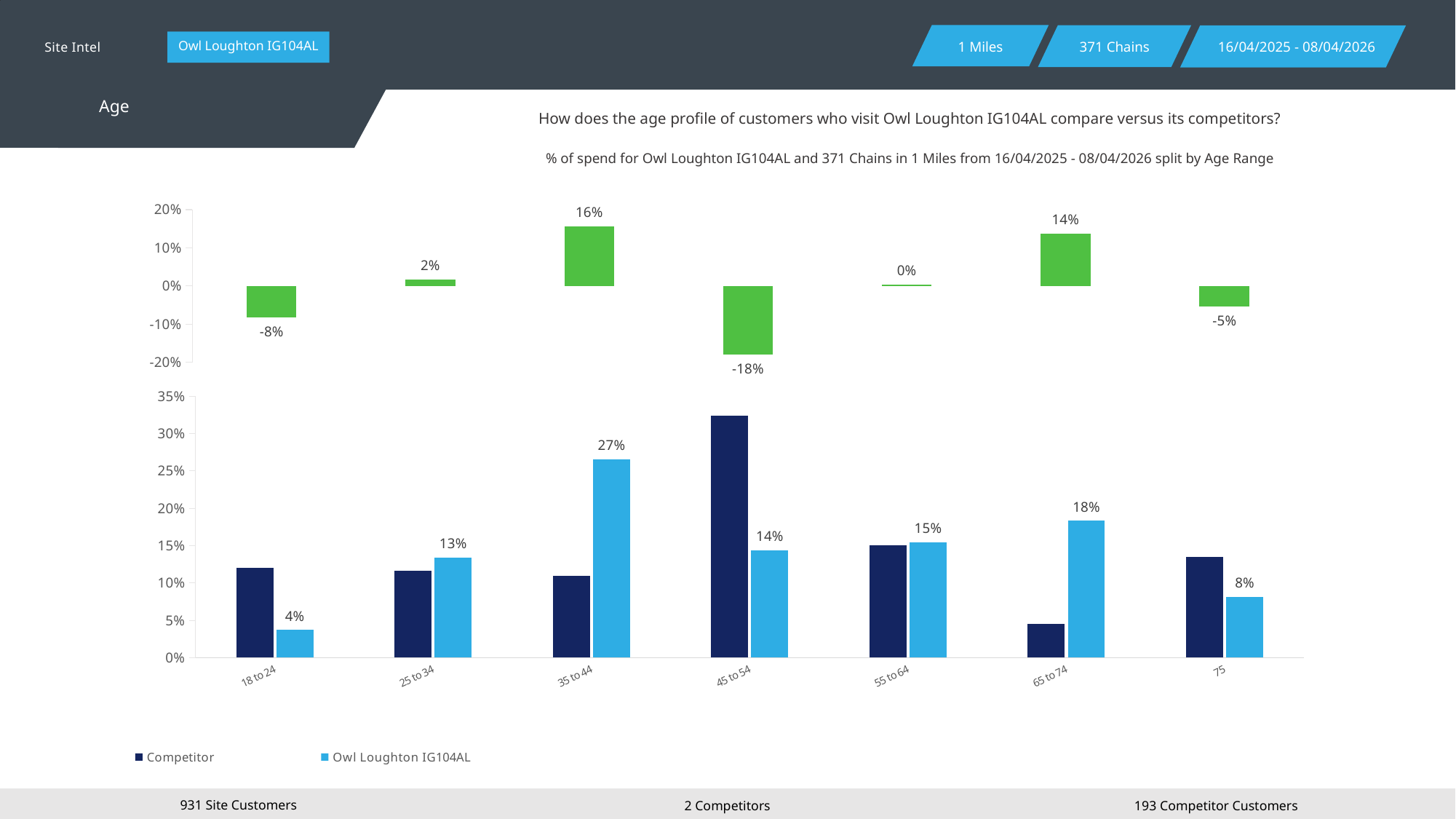
In the top chart, what is the value for the 18 to 24 age range? -8% In the bottom chart, what is the Owl Loughton IG104AL value for the 35 to 44 age range? 27% In the top chart, which age range has the highest value? 35 to 44 In the bottom chart, for the 45 to 54 age range, which series has the larger value, Competitor or Owl Loughton IG104AL? Competitor In the bottom chart, is the Competitor value for the 45 to 54 age range greater or less than 30%? greater In the top chart, which age range has the lowest value? 45 to 54 In the bottom chart, which age range has the lowest Owl Loughton IG104AL value? 18 to 24 How many series does the legend of the bottom chart list? 2 In the bottom chart, which age range has the highest Owl Loughton IG104AL value? 35 to 44 In the bottom chart, what is the difference between the Owl Loughton IG104AL values for 65 to 74 and 75? 10% In the top chart, what is the value for the 35 to 44 age range? 16% How many age range categories are shown on the x axis of the bottom chart? 7